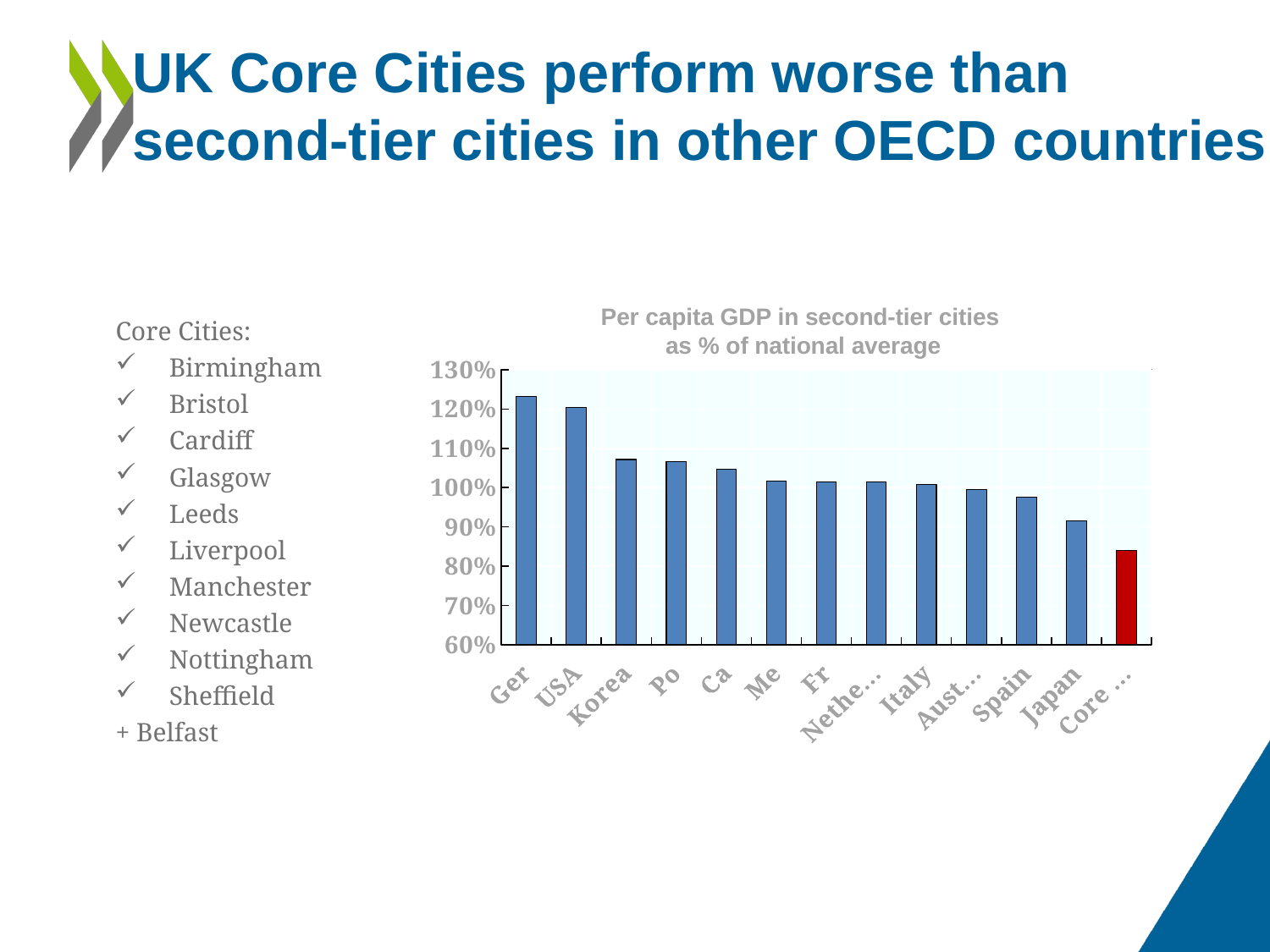
Which has the larger value, USA or Spain? USA Which category has the lowest value in the chart? Core ... How many bars are plotted in the chart? 13 What is the title of the chart? Per capita GDP in second-tier cities as % of national average Is the value for Korea greater or less than 100%? greater Is the value for Japan greater or less than 100%? less What kind of chart is shown on the slide? bar chart Which category has the highest value in the chart? Ger Is the value for Ger greater or less than 110%? greater What colour is the bar for Core ..., the rightmost bar? red Do the values rise or fall moving from left to right along the x axis? fall